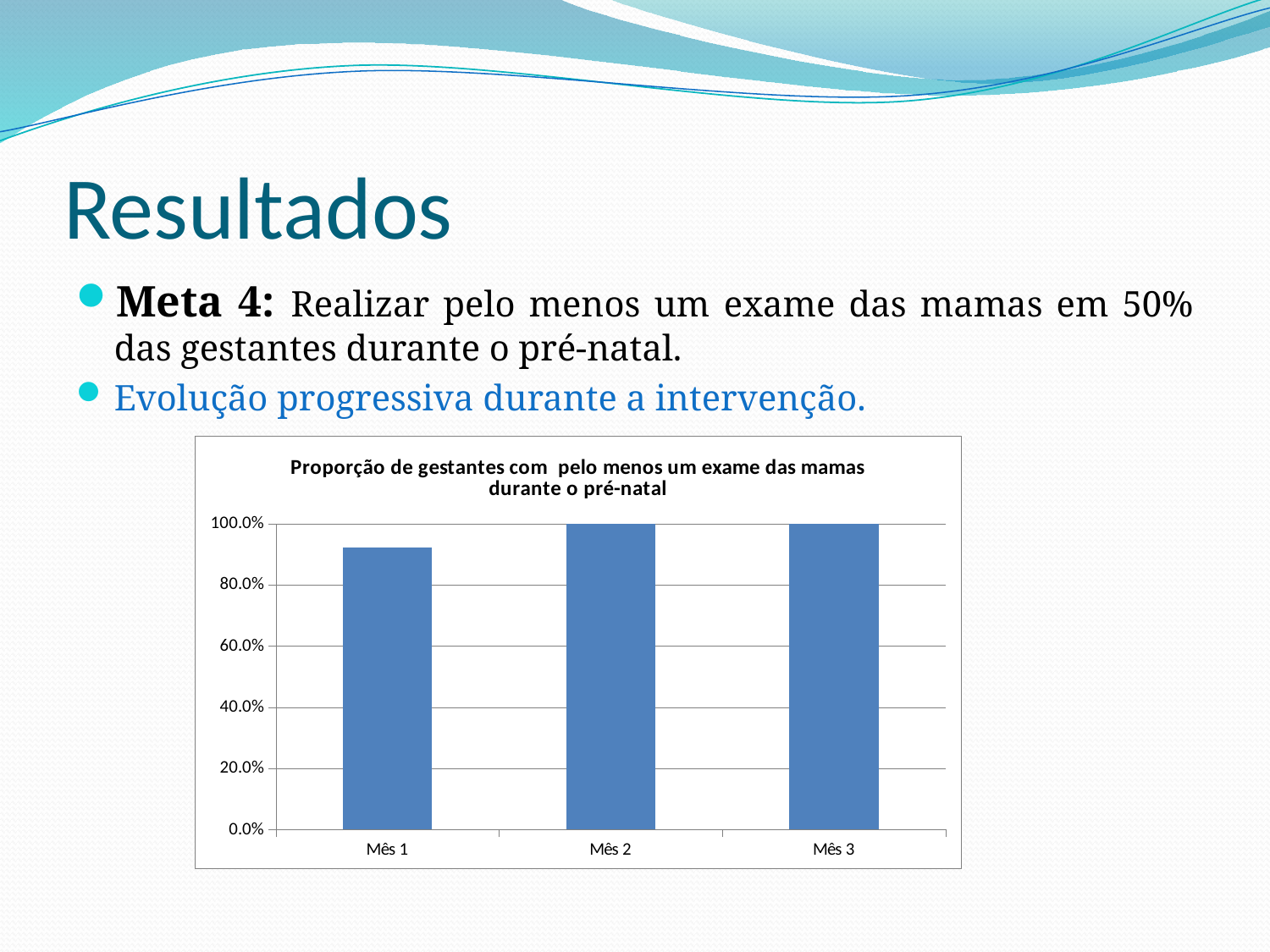
Is the value for Mês 1 greater or less than 100.0%? less Is the value for Mês 1 greater or less than 80.0%? greater What is the value for Mês 3 in the chart? 100.0% Which month has the lowest proportion of pregnant women with at least one breast exam? Mês 1 Which is larger, the value for Mês 1 or the value for Mês 2? Mês 2 Do the values rise or fall from Mês 1 to Mês 3? rise What is the value for Mês 2 in the chart? 100.0% How many categories (months) are shown on the x axis of the chart? 3 What is the title of the chart? Proporção de gestantes com pelo menos um exame das mamas durante o pré-natal What is the highest value shown on the y axis of the chart? 100.0% What kind of chart is shown on the slide? bar chart Which is larger, the value for Mês 1 or the value for Mês 3? Mês 3